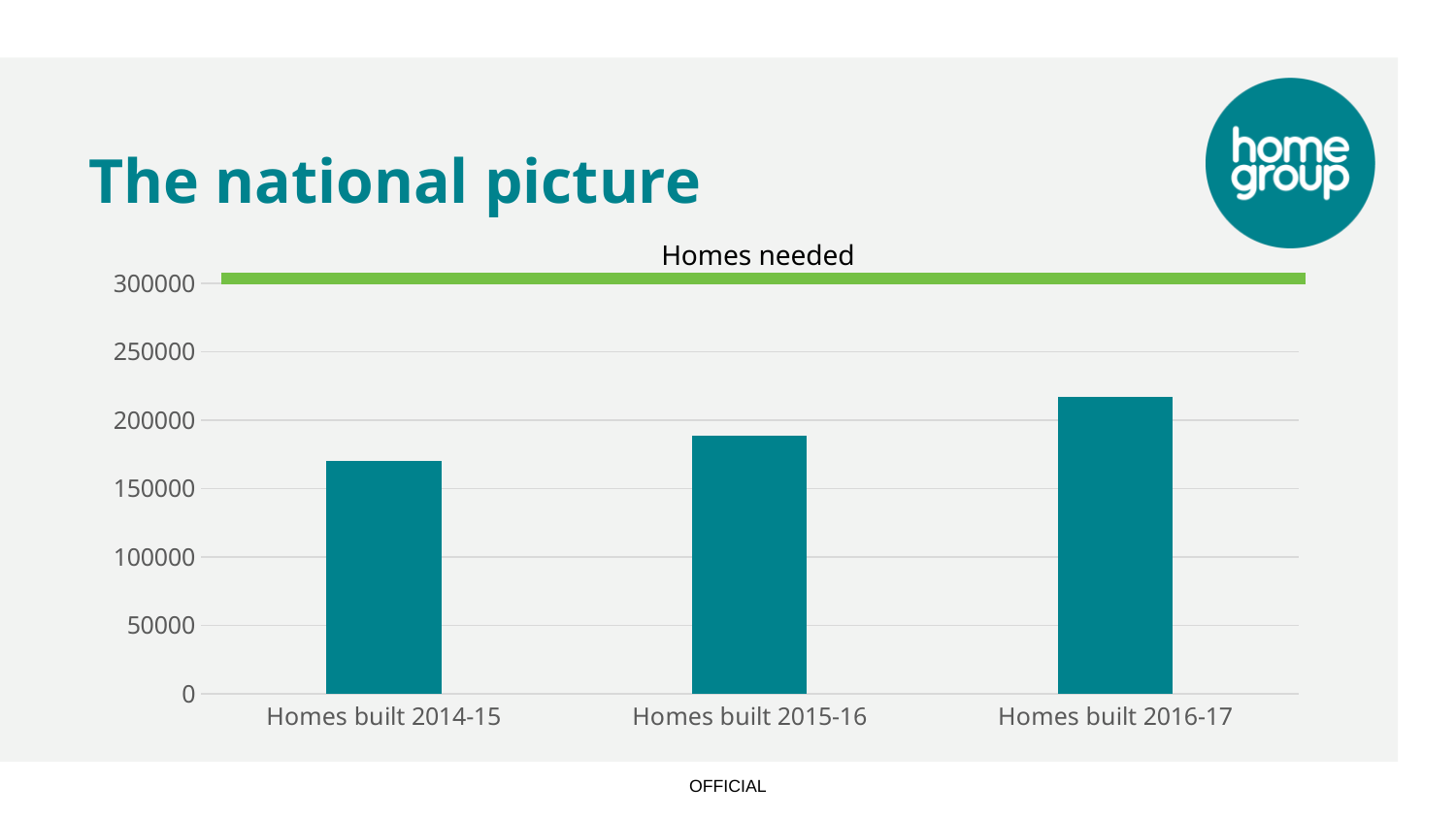
Which category has the highest bar? Homes built 2016-17 What kind of chart is shown on the slide? bar chart Is the value for Homes built 2014-15 greater or less than 200000? less Is the value for Homes built 2016-17 greater or less than 200000? greater What is the title of the slide? The national picture What is the label shown above the green horizontal line on the chart? Homes needed Is the value for Homes built 2015-16 greater or less than 150000? greater At what value on the vertical axis does the green 'Homes needed' line sit? 300000 How many bars are plotted in the chart? 3 Do the bar values rise or fall from Homes built 2014-15 to Homes built 2016-17? rise Which category has the lowest bar? Homes built 2014-15 Which is larger, the value for Homes built 2015-16 or Homes built 2016-17? Homes built 2016-17